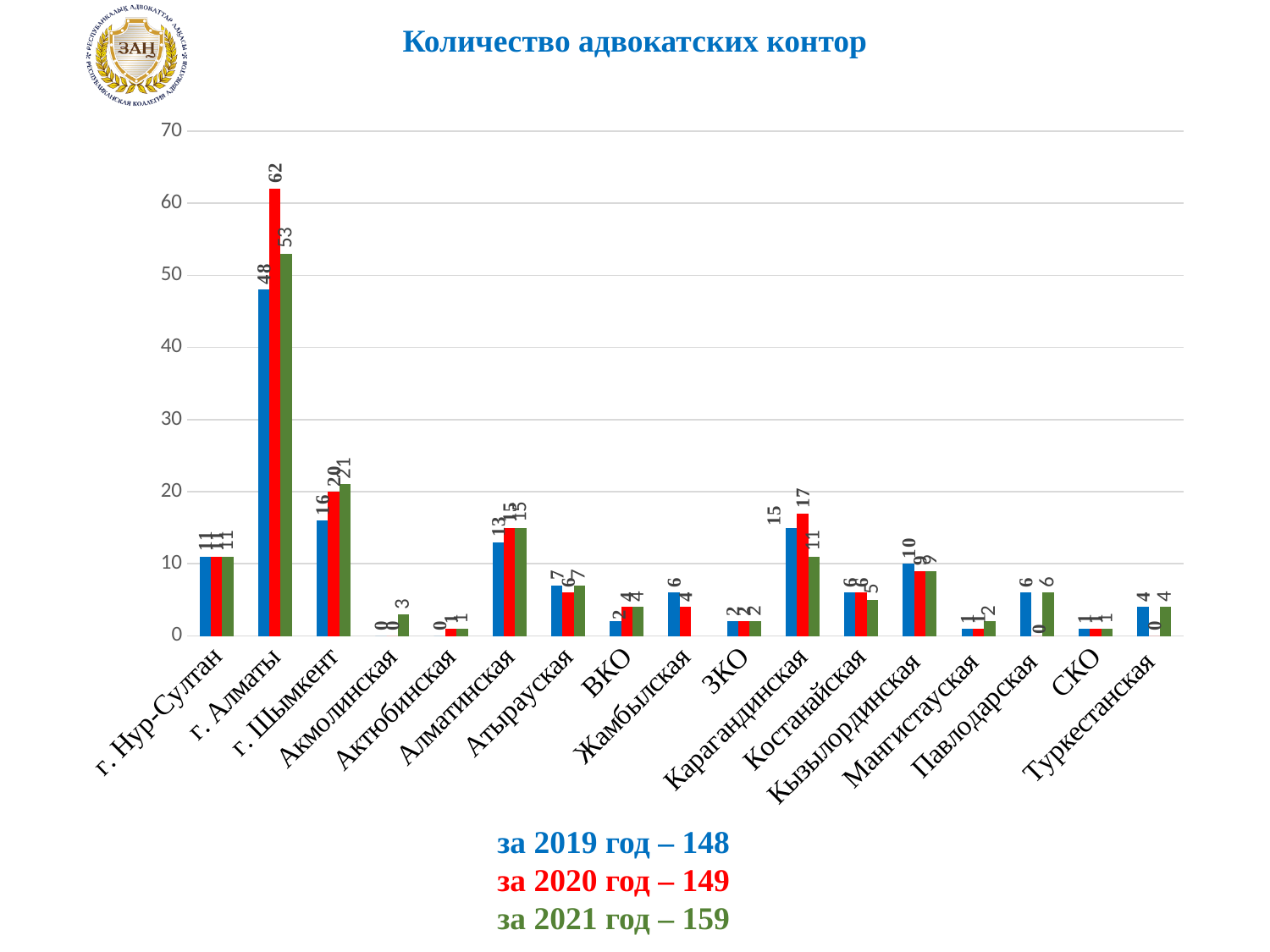
What is the value of the green (2021) bar for г. Шымкент? 21 What is the value of the blue (2019) bar for Карагандинская? 15 How many regions (categories) are shown on the x axis of the chart? 17 According to the text below the chart, what is the total for 2021? 159 What is the difference between the red (2020) and blue (2019) bars for г. Алматы? 14 Which is larger for Карагандинская: the red (2020) bar or the green (2021) bar? the red (2020) bar Which region has the highest bar in the chart? г. Алматы Is the value of the green (2021) bar for г. Алматы greater or less than 50? greater What type of chart is shown on the slide? bar chart What is the value of the red (2020) bar for г. Алматы? 62 What is the title of the chart? Количество адвокатских контор Do the values for г. Шымкент rise or fall from the blue (2019) bar to the green (2021) bar? rise